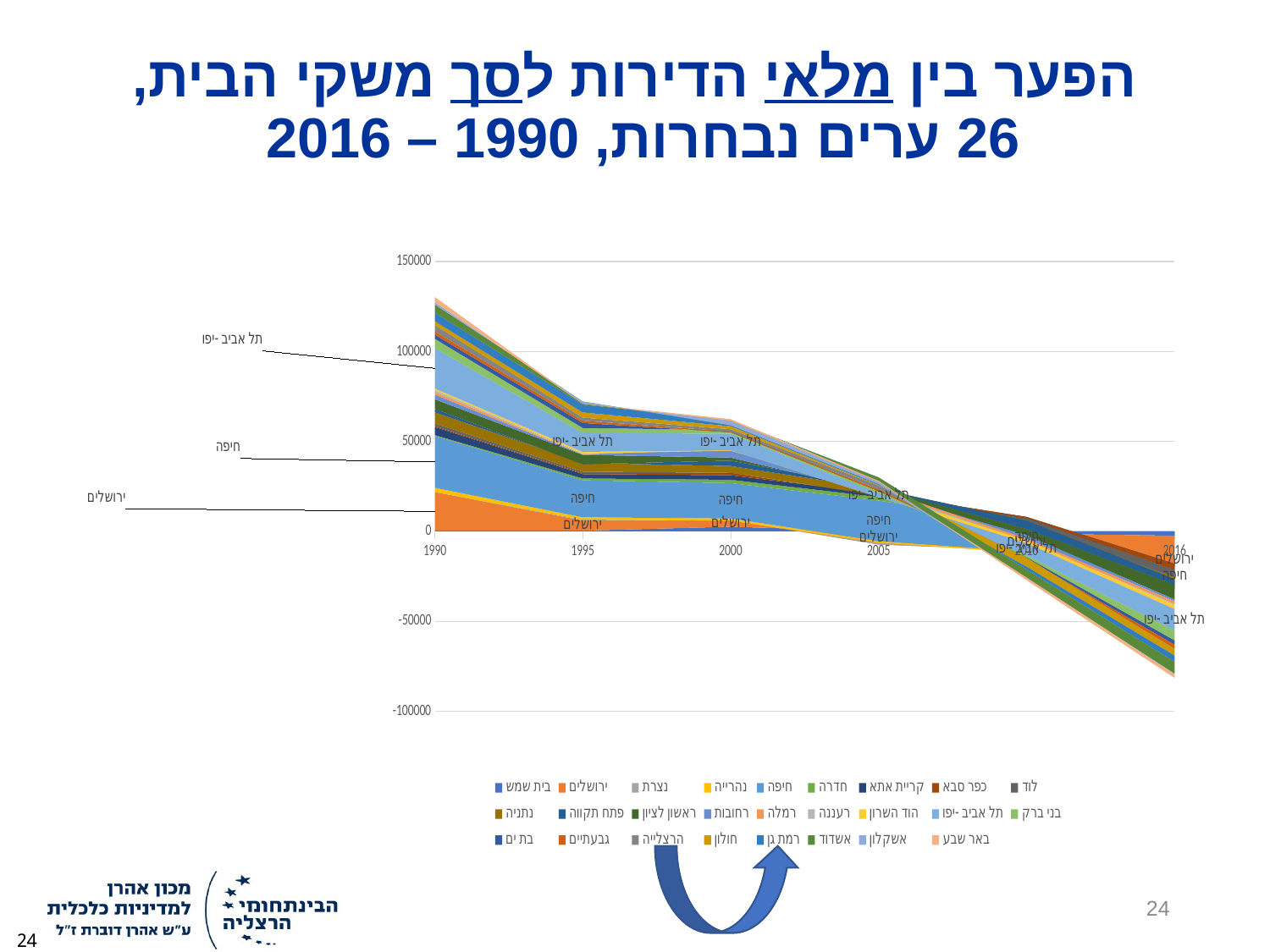
How many cities (series) does the chart legend list? 26 Is the stacked total for 1990 greater or less than 100000? greater Is the stacked total for 2000 greater or less than 50000? greater Is the lowest point of the stacked area in 2016 greater or less than -50000? less What is the highest value labelled on the y axis of the chart? 150000 What kind of chart is shown on the slide? stacked area chart Does the stacked total of the chart rise or fall from 1990 to 2016? fall Which of the two years, 1990 or 2005, has the larger stacked total? 1990 Which years are shown on the x axis of the chart? 1990, 1995, 2000, 2005, 2010, 2016 How many years are marked along the x axis of the chart? 6 Which year has the highest stacked total in the chart? 1990